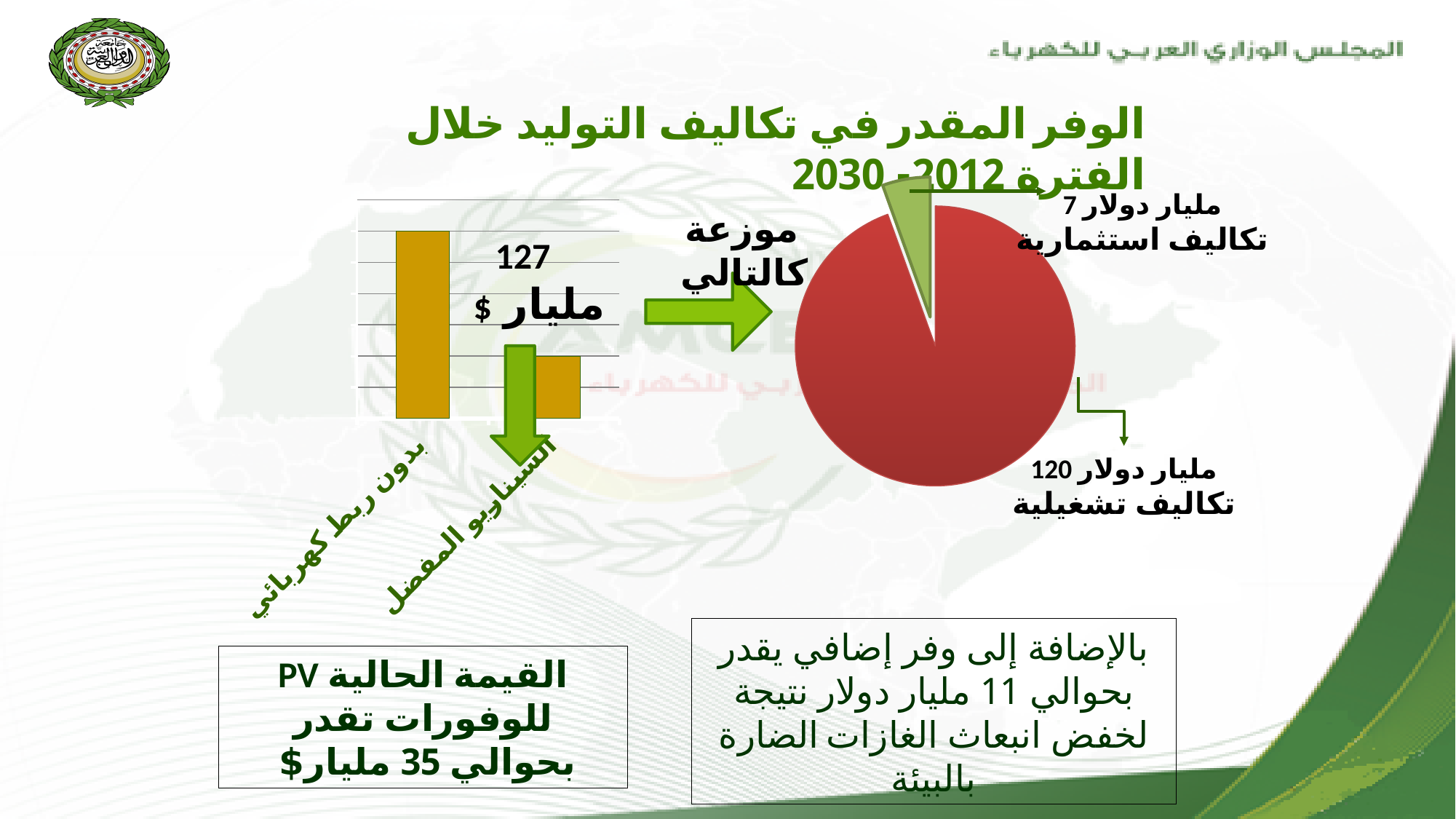
In the pie chart, what is the difference between the operating costs (تكاليف تشغيلية) and the investment costs (تكاليف استثمارية)? 113 مليار دولار In the bar chart, which bar is taller: بدون ربط كهربائي or السيناريو المفضل? بدون ربط كهربائي In the pie chart, what is the total of the two slices? 127 مليار دولار In the pie chart, which slice is the largest? تكاليف تشغيلية In the pie chart, which slice is the smallest? تكاليف استثمارية What type of chart is on the left side of the slide? bar chart In the pie chart, what is the value for تكاليف تشغيلية (operating costs)? 120 مليار دولار What type of chart is on the right side of the slide? pie chart In the bar chart, what is the difference between the two bars as labelled on the slide? 127 مليار $ How many slices does the pie chart have? 2 How many bars does the bar chart on the left have? 2 In the pie chart, what is the value for تكاليف استثمارية (investment costs)? 7 مليار دولار